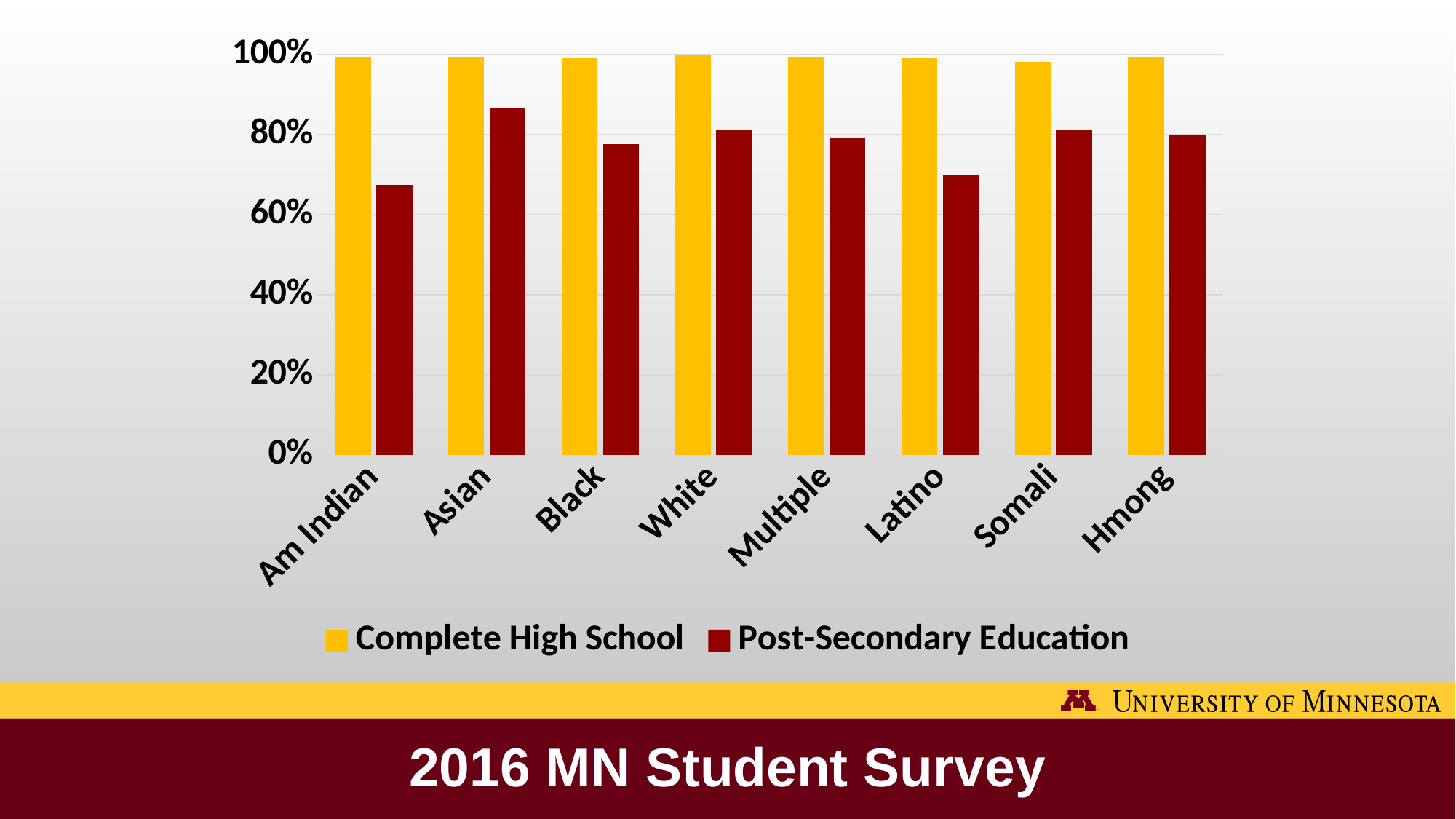
Is the Post-Secondary Education value for Latino greater or less than 80%? less Is the Post-Secondary Education value for Asian greater or less than 80%? greater How many categories are shown on the x axis? 8 Which category has the lowest Post-Secondary Education value? Am Indian Is the Post-Secondary Education value for Am Indian greater or less than 80%? less What colour are the Post-Secondary Education bars? dark red What kind of chart is shown on the slide? bar chart Which category has the highest Post-Secondary Education value? Asian How many series does the legend list? 2 Which has the larger Post-Secondary Education value, Asian or Latino? Asian For Am Indian, which series has the larger value, Complete High School or Post-Secondary Education? Complete High School